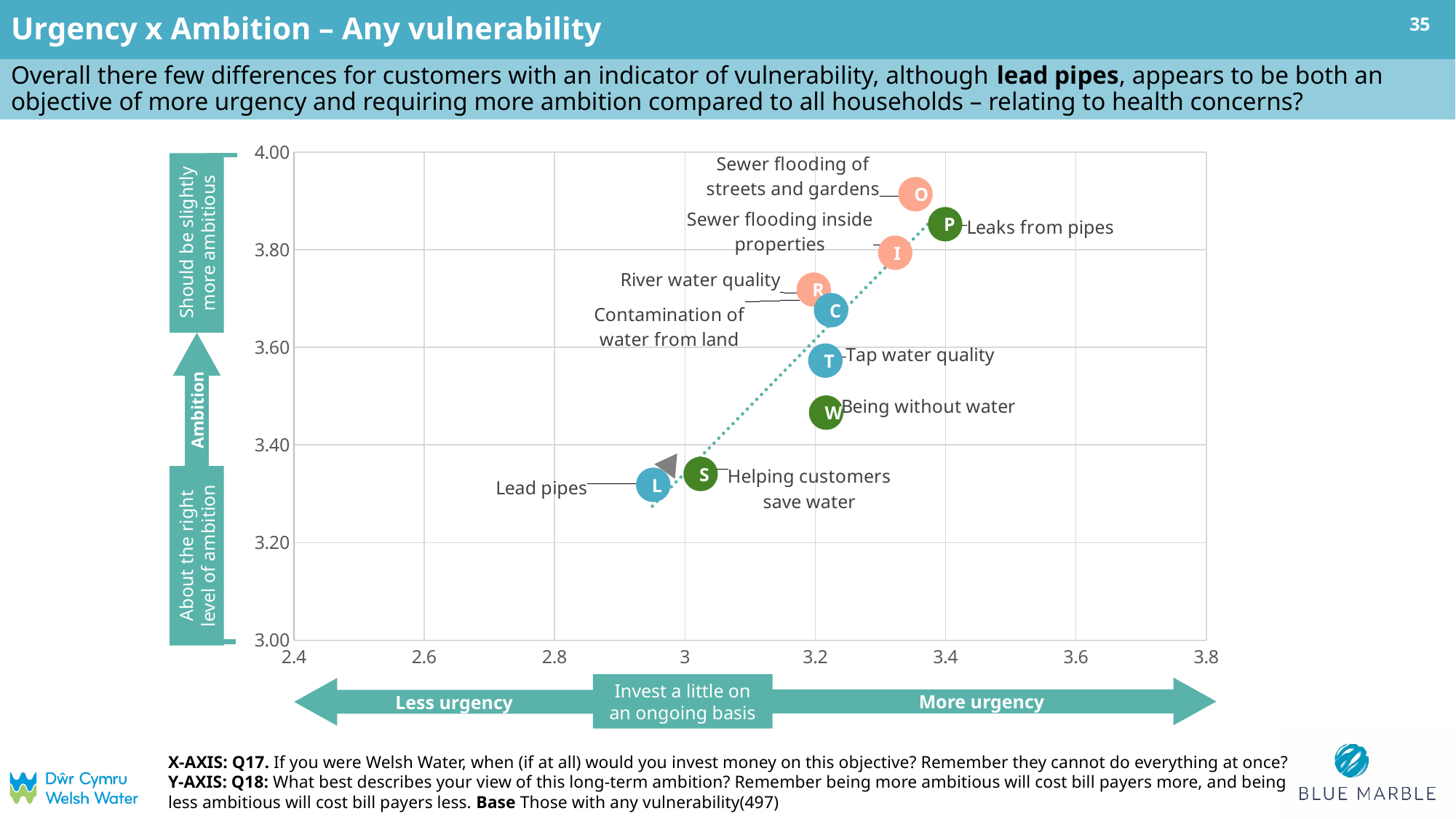
Is the ambition (y-axis) value for Leaks from pipes greater or less than 3.80? greater How many objectives are plotted as points on the chart? 9 Is the urgency (x-axis) value for Lead pipes greater or less than 3? less Is the urgency (x-axis) value for Sewer flooding of streets and gardens greater or less than 3.2? greater Which objective has the highest ambition score (highest on the y axis)? Sewer flooding of streets and gardens What is the highest value shown on the y axis of the chart? 4.00 What kind of chart is shown on the slide? Scatter chart Which has the higher ambition score: Tap water quality or Being without water? Tap water quality As urgency increases along the x axis, do the ambition scores generally rise or fall? Rise Which objective has the highest urgency score (furthest right on the x axis)? Leaks from pipes Which objective has the lowest urgency score (furthest left on the x axis)? Lead pipes